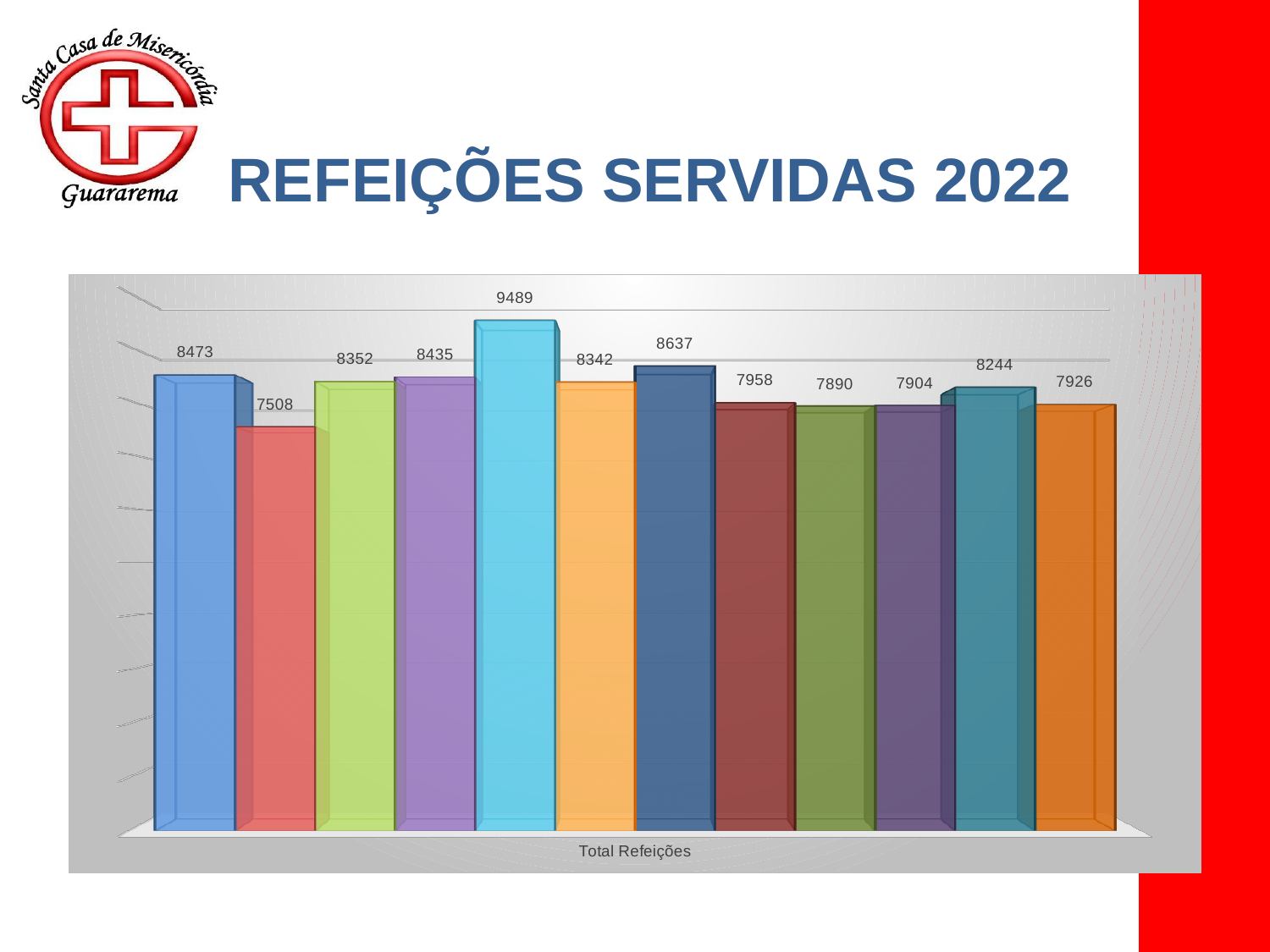
What is the value of the last (rightmost, orange) bar? 7926 What is the difference between the highest bar (9489) and the lowest bar (7508)? 1981 What is the title of the slide containing the chart? REFEIÇÕES SERVIDAS 2022 What label appears on the horizontal axis of the chart? Total Refeições Which is larger, the value of the first bar (8473) or the value of the third bar (8352)? 8473 What is the value of the second (red) bar? 7508 What is the lowest value shown in the chart? 7508 What is the value of the first (leftmost, blue) bar? 8473 What is the value of the seventh (dark blue) bar? 8637 How many bars are plotted in the chart? 12 What is the highest value shown in the chart? 9489 What kind of chart is shown on the slide? bar chart